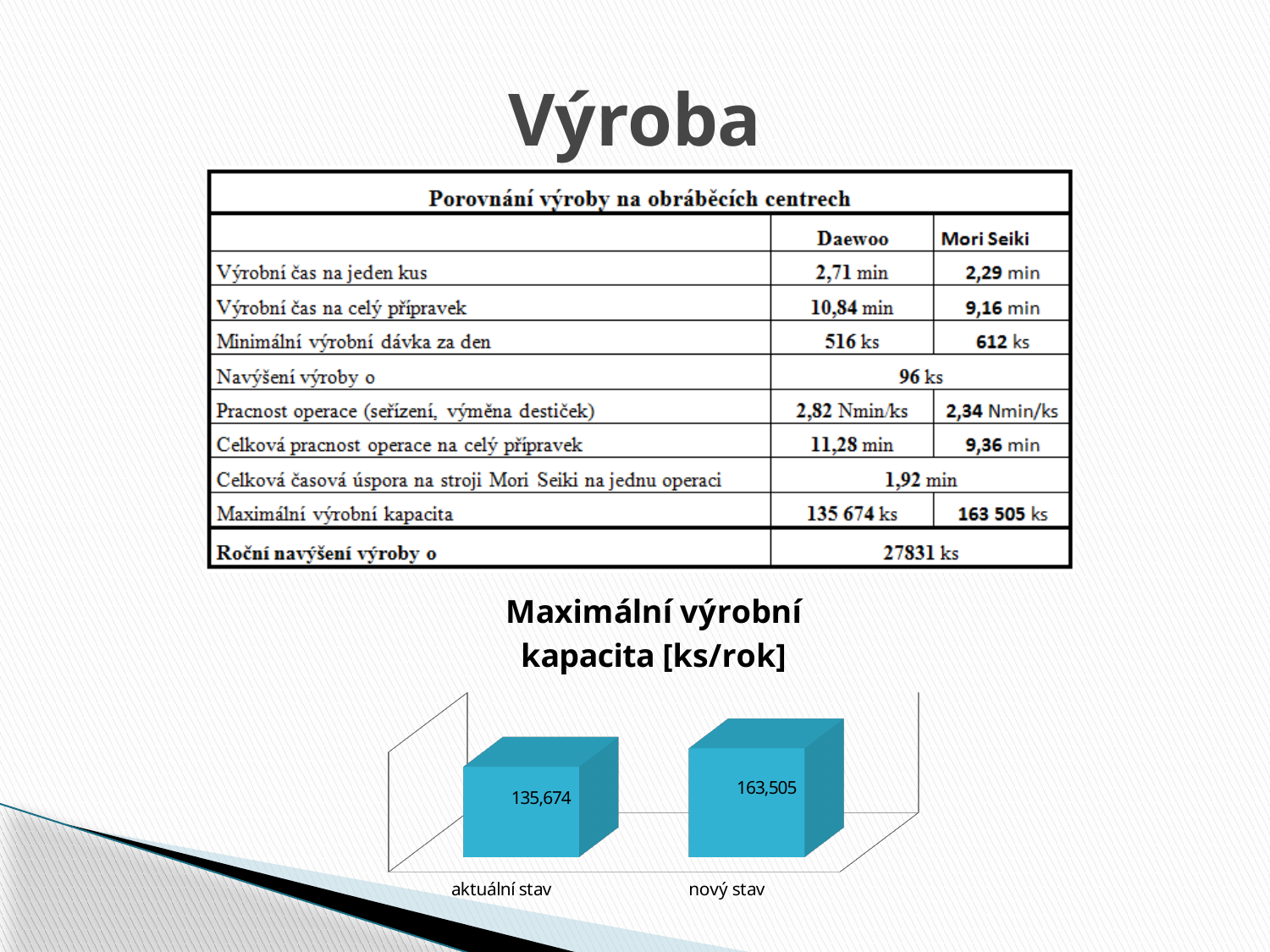
Which category has the highest value in the chart? nový stav What is the title of the chart? Maximální výrobní kapacita [ks/rok] What is the value for "nový stav" in the chart? 163,505 Which category has the lowest value in the chart? aktuální stav What colour are the bars in the chart? blue Do the values in the chart rise or fall from left to right? rise How many categories are shown in the chart? 2 What is the difference between the values for "nový stav" and "aktuální stav" in the chart? 27,831 Which is larger in the chart: the value for "aktuální stav" or the value for "nový stav"? nový stav What kind of chart is shown on the slide? bar chart What is the value for "aktuální stav" in the chart? 135,674